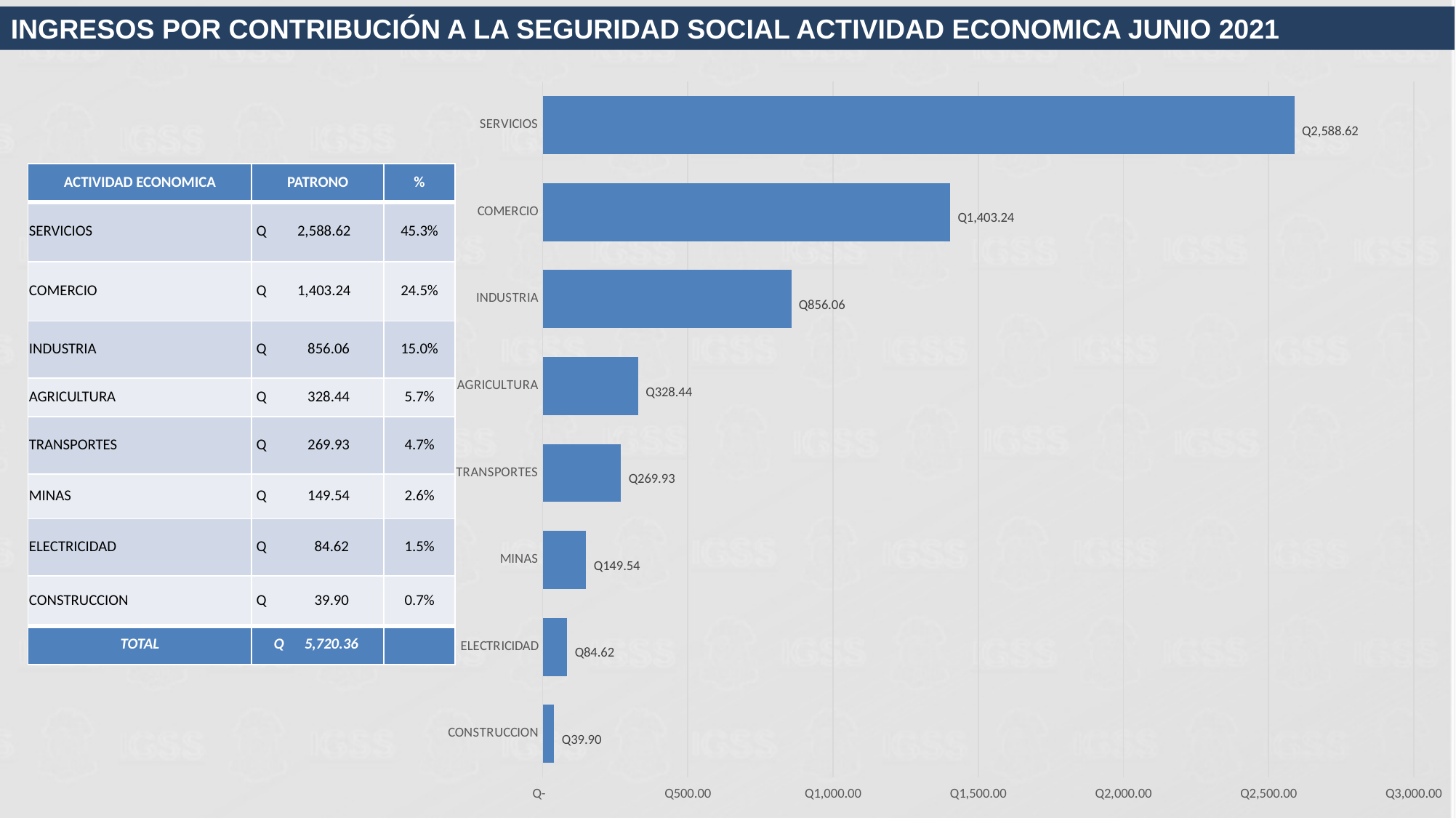
Which is larger in the bar chart, AGRICULTURA or TRANSPORTES? AGRICULTURA What is the value for INDUSTRIA in the bar chart? Q856.06 What is the difference between the values for COMERCIO and INDUSTRIA in the bar chart? Q547.18 Which category has the highest value in the bar chart? SERVICIOS Is the value for COMERCIO in the bar chart greater or less than Q1,500.00? less What kind of chart is shown on the slide? bar chart What is the maximum value shown on the horizontal axis of the bar chart? Q3,000.00 Which category has the lowest value in the bar chart? CONSTRUCCION What is the value for SERVICIOS in the bar chart? Q2,588.62 How many categories are shown in the bar chart? 8 What is the value for MINAS in the bar chart? Q149.54 What is the difference between the values for ELECTRICIDAD and CONSTRUCCION in the bar chart? Q44.72